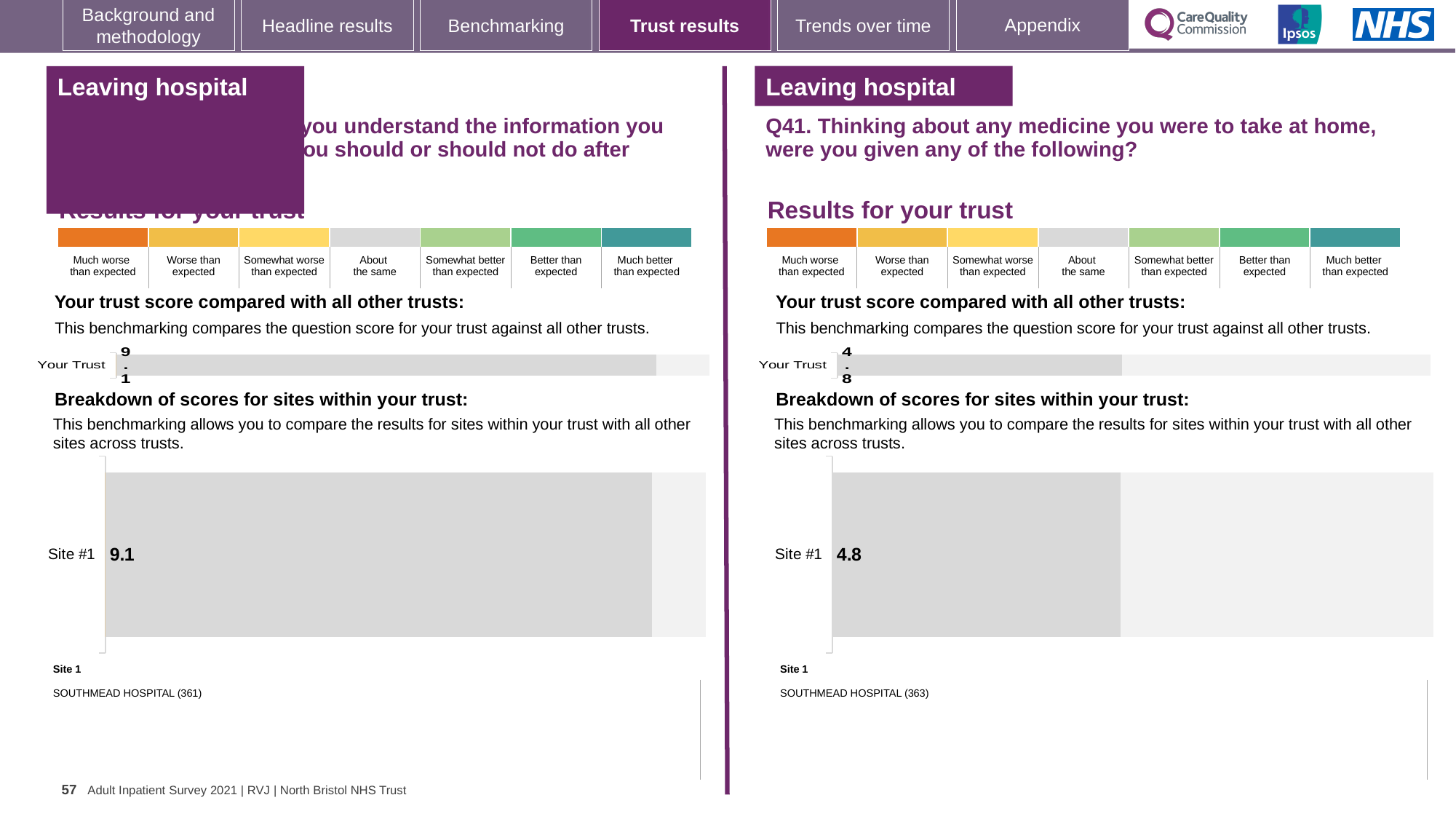
How many sites are shown in the right-hand site breakdown chart (Q41)? 1 In the left-hand site breakdown chart, what is the score for Site #1? 9.1 Is the Site #1 score in the left-hand chart greater or less than the Your Trust score in the right-hand chart (Q41)? greater How many sites are shown in the left-hand site breakdown chart? 1 In the right-hand site breakdown chart (Q41), what is the score for Site #1? 4.8 What is the difference between the Site #1 score in the left-hand chart and the Site #1 score in the right-hand chart (Q41)? 4.3 Which hospital is listed as Site 1 in the right-hand site breakdown (Q41)? SOUTHMEAD HOSPITAL (363) On the right half of the slide (Q41), what is the score shown for Your Trust? 4.8 What type of chart is used for the site breakdown on the right half of the slide? Bar chart Which hospital is listed as Site 1 in the left-hand site breakdown? SOUTHMEAD HOSPITAL (361) On the left half of the slide, what is the score shown for Your Trust? 9.1 Which is larger: the Your Trust score on the left half of the slide or the Your Trust score on the right half (Q41)? Left half (9.1)